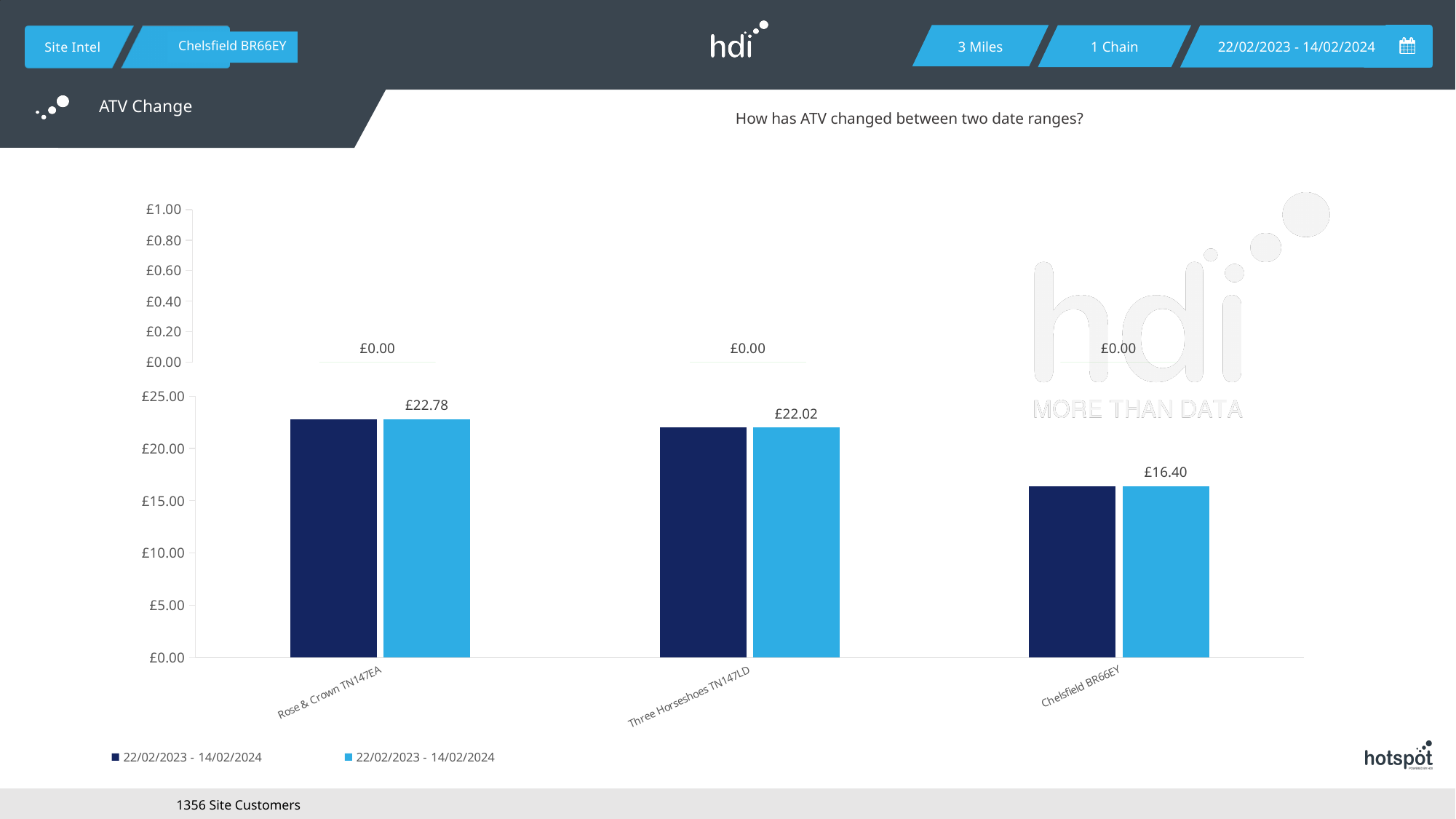
Which site has the lowest labelled ATV in the lower chart? Chelsfield BR66EY Is the ATV for Chelsfield BR66EY greater or less than £20.00? less What is the ATV value labelled for Three Horseshoes TN147LD in the lower chart? £22.02 Which is larger, the labelled ATV for Three Horseshoes TN147LD or for Chelsfield BR66EY? Three Horseshoes TN147LD How many series does the legend list? 2 In the upper chart, what change value is shown for Rose & Crown TN147EA? £0.00 What is the difference between the labelled ATV for Rose & Crown TN147EA and Chelsfield BR66EY? £6.38 What is the ATV value labelled for Rose & Crown TN147EA in the lower chart? £22.78 What is the ATV value labelled for Chelsfield BR66EY in the lower chart? £16.40 Which site has the highest labelled ATV in the lower chart? Rose & Crown TN147EA What type of chart is shown on the slide? bar chart How many sites are shown on the x axis of the chart? 3